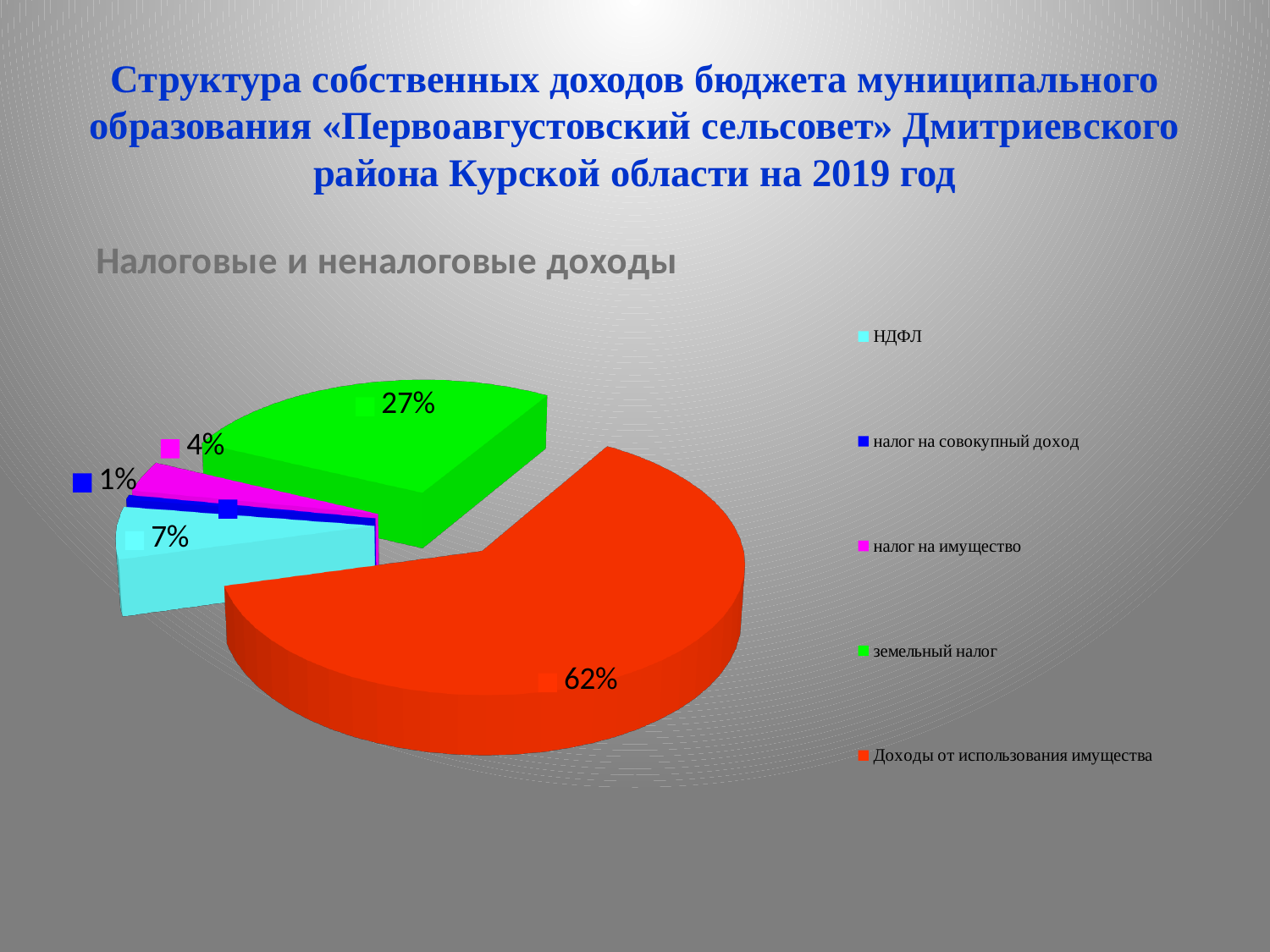
How many slices does the pie chart have? 5 What is the value for налог на имущество? 4% What kind of chart is shown on the slide? pie chart What is the difference between the shares of Доходы от использования имущества and земельный налог? 35% What share of the pie is земельный налог? 27% What is the value for НДФЛ? 7% How many entries does the legend list? 5 What is the chart's title? Налоговые и неналоговые доходы Which category has the smallest share of the pie? налог на совокупный доход Which category has the largest share of the pie? Доходы от использования имущества What is the value for налог на совокупный доход? 1% What share of the pie is Доходы от использования имущества? 62%